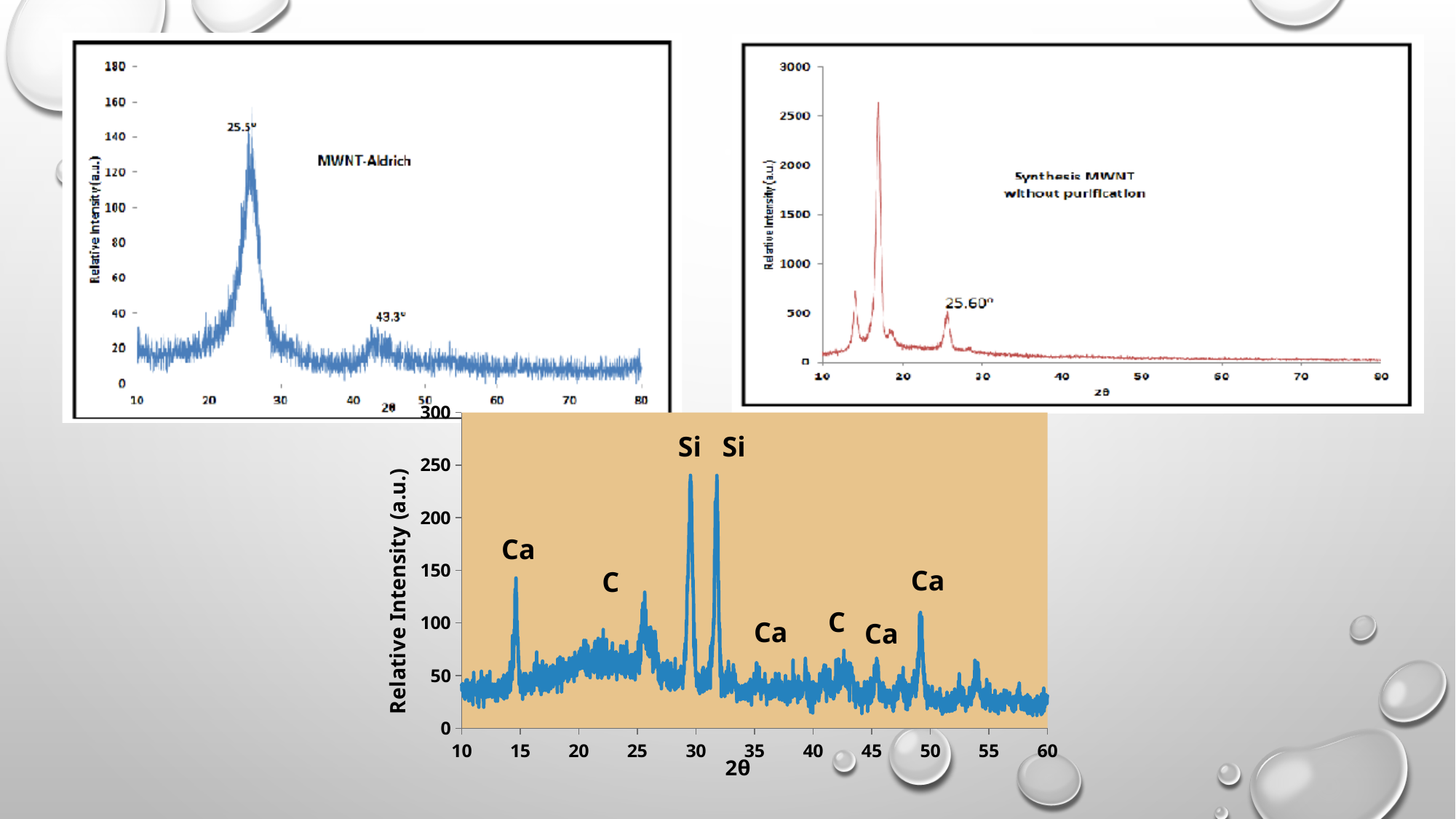
What kind of chart is the bottom chart with the Ca, C and Si labels? line chart In the MWNT-Aldrich chart, at what 2θ angle is the smaller labelled peak? 43.3° In the bottom chart, which element is labelled on the two tallest peaks? Si In the Synthesis MWNT without purification chart, what 2θ angle is labelled on the peak? 25.60° In the Synthesis MWNT without purification chart, is the peak labelled 25.60° greater or less than 1000 in relative intensity? less In the MWNT-Aldrich chart, is the peak at 25.5° greater or less than 100 in relative intensity? greater In the MWNT-Aldrich chart, is the peak at 43.3° greater or less than 80 in relative intensity? less What is the title of the top-right chart? Synthesis MWNT without purification In the bottom chart, how many peaks are labelled Ca? 4 What is the title of the top-left chart? MWNT-Aldrich In the MWNT-Aldrich chart, at what 2θ angle is the main peak labelled? 25.5°